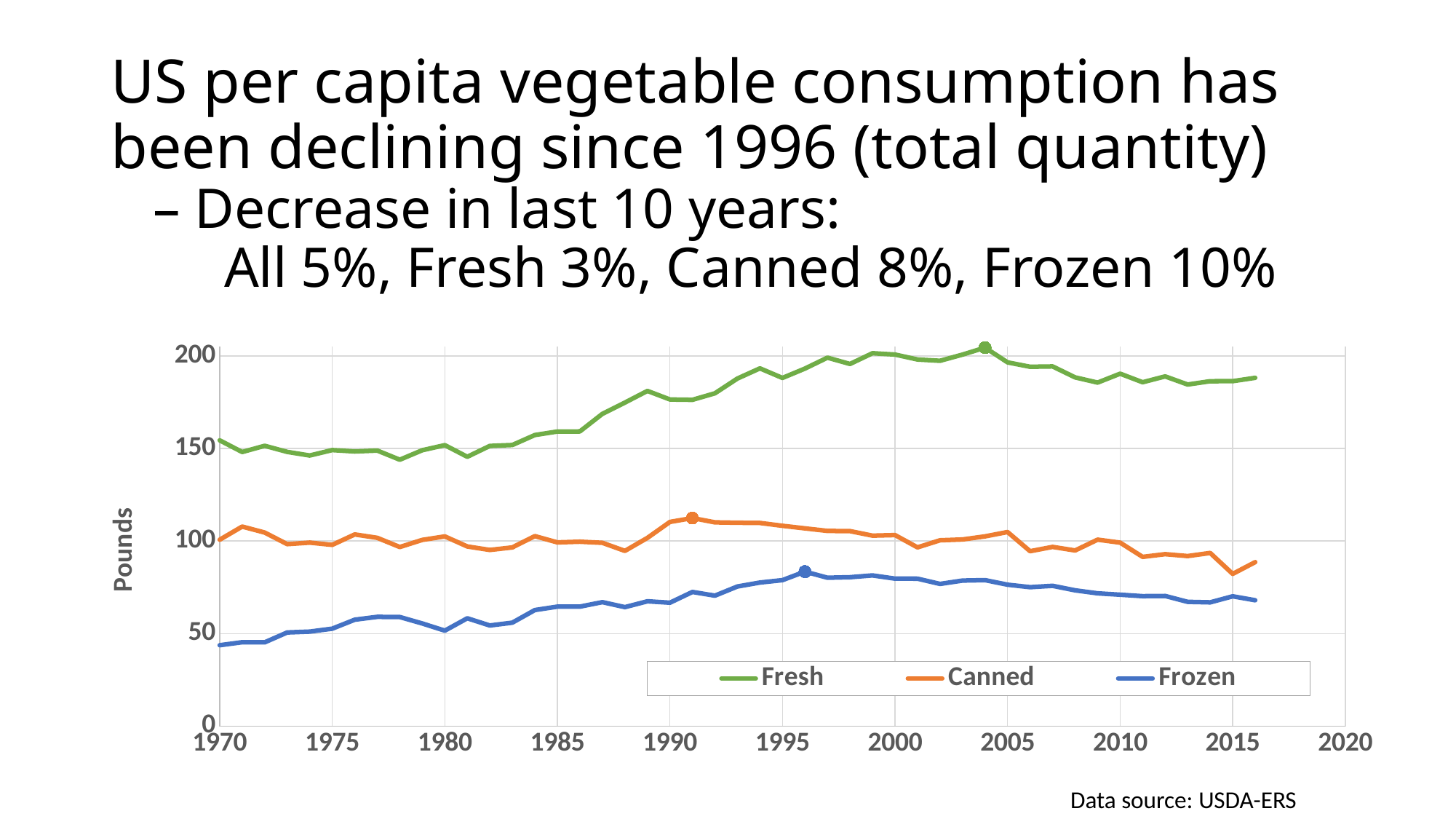
In 2000, which is larger, the value for Fresh or the value for Canned? Fresh Is the value for Canned in 1991 greater or less than 100? greater Is the value for Fresh in 1990 greater or less than 150? greater Which series has the lowest values across the whole period? Frozen Is the value for Canned in 2015 greater or less than 100? less What kind of chart is shown on the slide? line chart What is the label on the vertical axis? Pounds Does the Fresh series generally rise or fall between 1970 and 2004? rise Which series has the highest values across the whole period? Fresh How many series does the legend list? 3